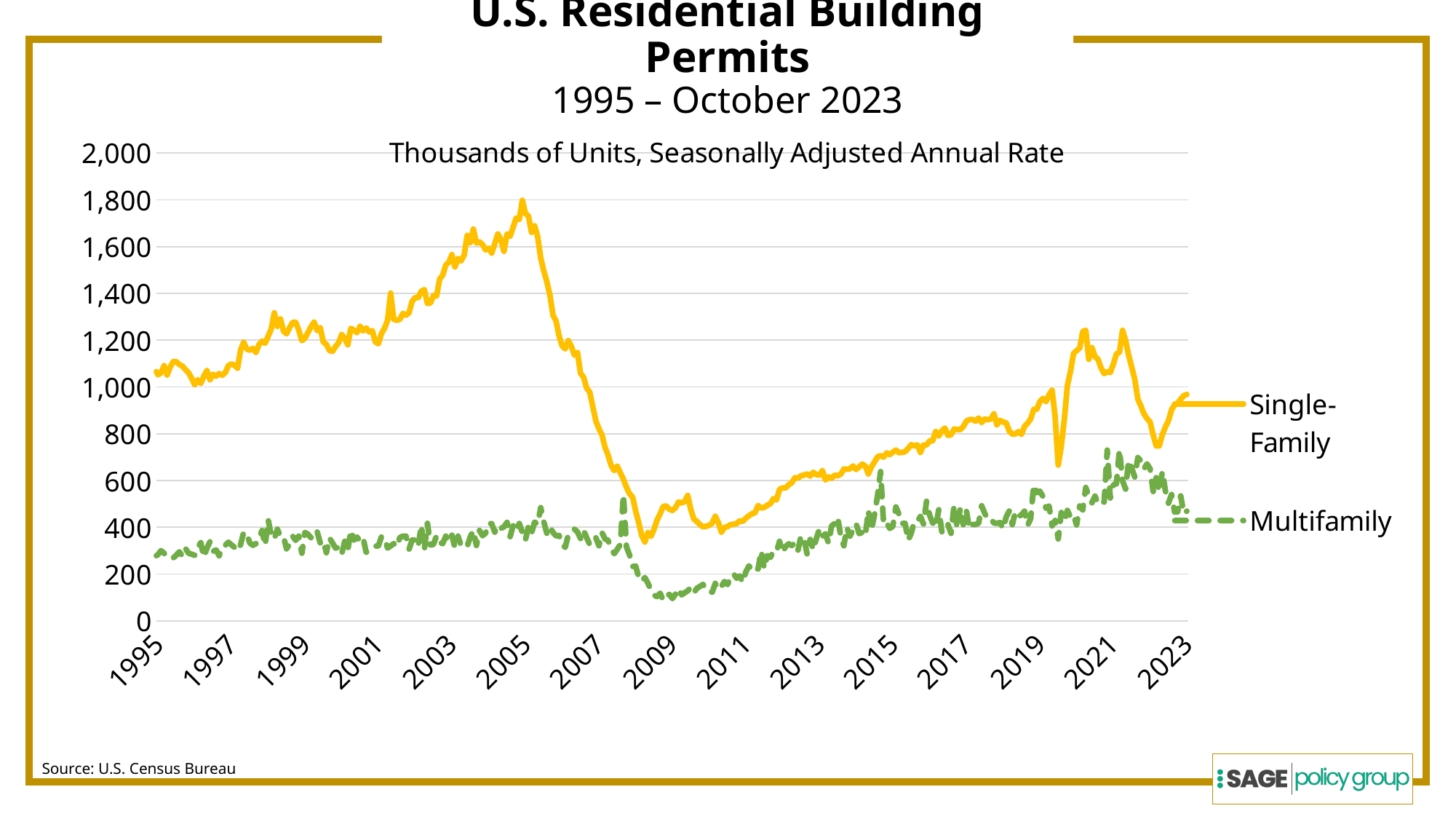
Which series reaches the highest value anywhere on the chart? Single-Family What unit is the y axis measured in, according to the chart subtitle? Thousands of Units, Seasonally Adjusted Annual Rate How many series does the chart show? 2 What kind of chart is shown on the slide? Line chart Which series is higher in 2005, Single-Family or Multifamily? Single-Family Does the Single-Family series rise or fall between 2005 and 2009? Fall Is the peak value of the Single-Family series around 2005 greater or less than 1,600? greater Is the lowest value of the Single-Family series around 2009 greater or less than 600? less Is the peak value of the Multifamily series around 2021–2022 greater or less than 600? greater What are the two series shown in the chart? Single-Family and Multifamily